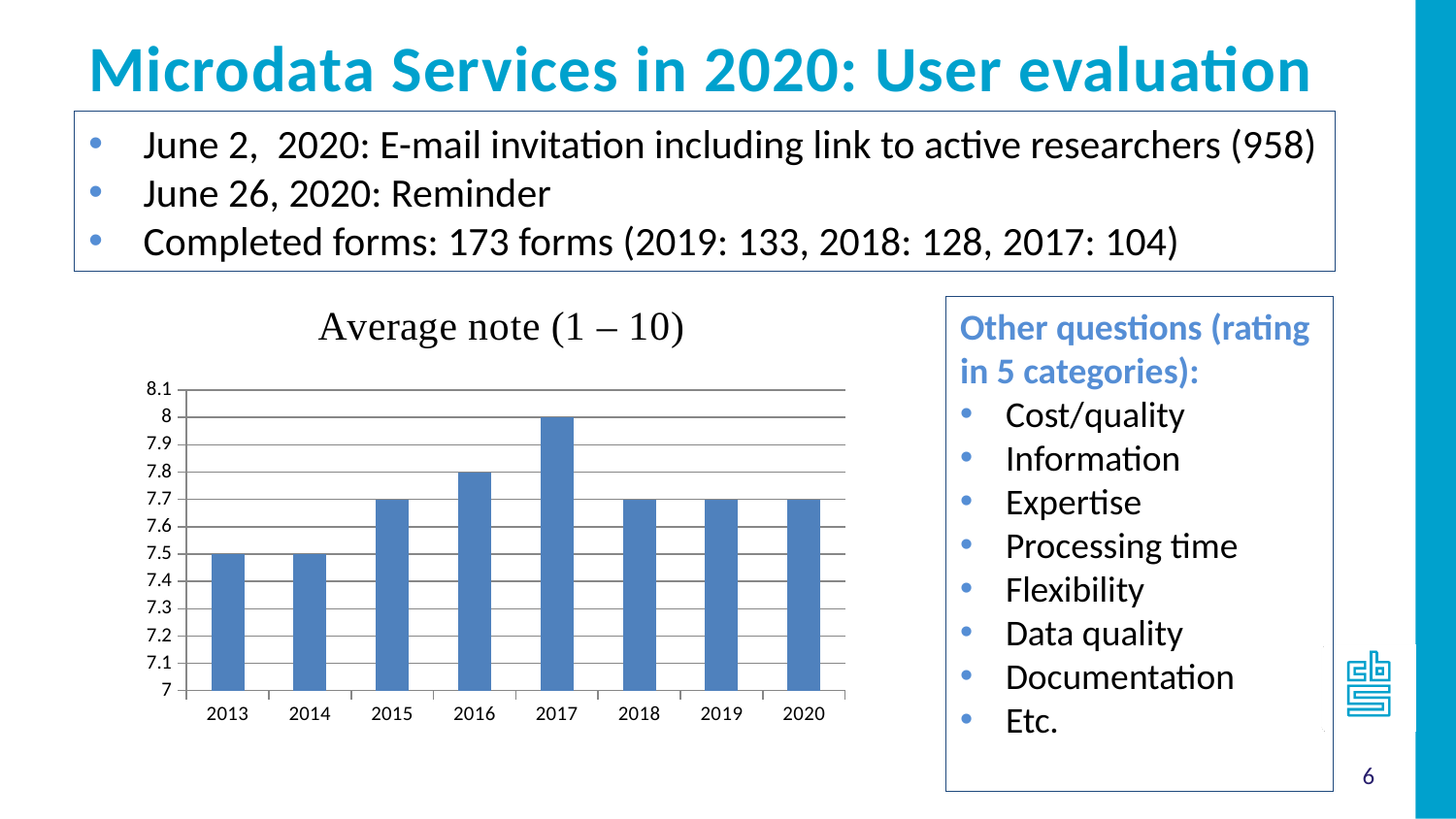
What is the difference between the average note for 2017 and for 2013? 0.5 Which is larger, the average note for 2016 or for 2018? 2016 What is the title of the chart? Average note (1 – 10) Which year has the highest average note? 2017 What is the average note for 2016? 7.8 Is the average note for 2014 greater or less than 7.6? less What type of chart is shown on the slide? bar chart What is the average note for 2020? 7.7 How many years are shown on the x axis of the chart? 8 Is the average note for 2017 greater or less than 7.9? greater What is the average note for 2017? 8 What is the average note for 2013? 7.5